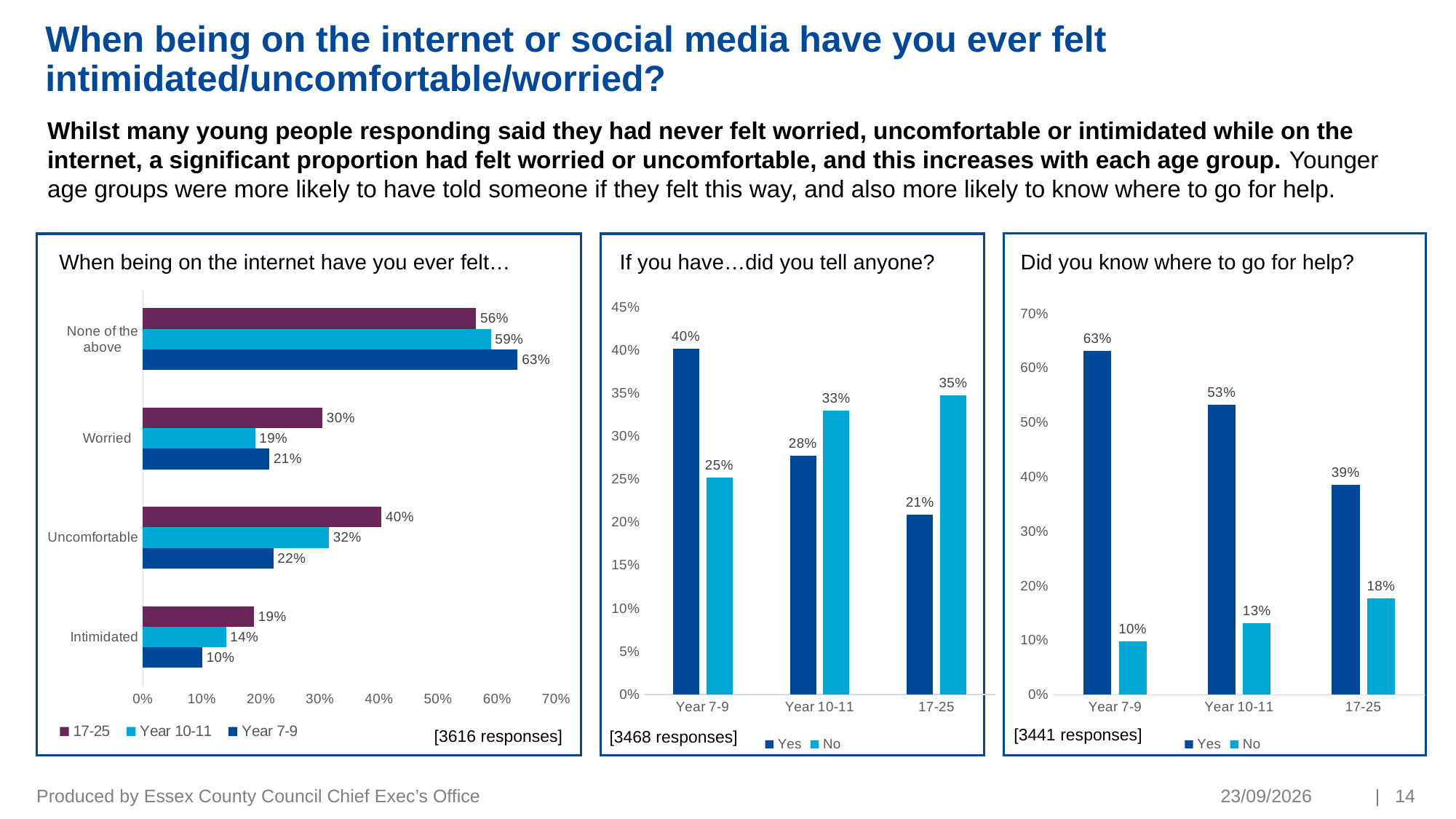
In the chart titled 'If you have…did you tell anyone?', what is the 'Yes' value for Year 10-11? 28% In the chart titled 'When being on the internet have you ever felt…', what is the value for 'Worried' for the 17-25 series? 30% In the chart titled 'If you have…did you tell anyone?', does the 'Yes' value fall or rise across the age groups from Year 7-9 to 17-25? Fall In the chart titled 'When being on the internet have you ever felt…', which age group has the highest value for 'None of the above'? Year 7-9 In the chart titled 'When being on the internet have you ever felt…', what is the difference between the 17-25 and Year 7-9 values for 'Uncomfortable'? 18% In the chart titled 'When being on the internet have you ever felt…', what is the value for 'Intimidated' for Year 7-9? 10% What type of chart is the chart titled 'Did you know where to go for help?'? Bar chart In the chart titled 'Did you know where to go for help?', which is larger: the 'Yes' value for Year 10-11 or the 'Yes' value for 17-25? Year 10-11 In the chart titled 'Did you know where to go for help?', what is the 'No' value for 17-25? 18% In the chart titled 'When being on the internet have you ever felt…', how many series does the legend list? 3 In the chart titled 'If you have…did you tell anyone?', which age group has the lowest 'Yes' value? 17-25 In the chart titled 'Did you know where to go for help?', what is the difference between the 'Yes' and 'No' values for Year 7-9? 53%